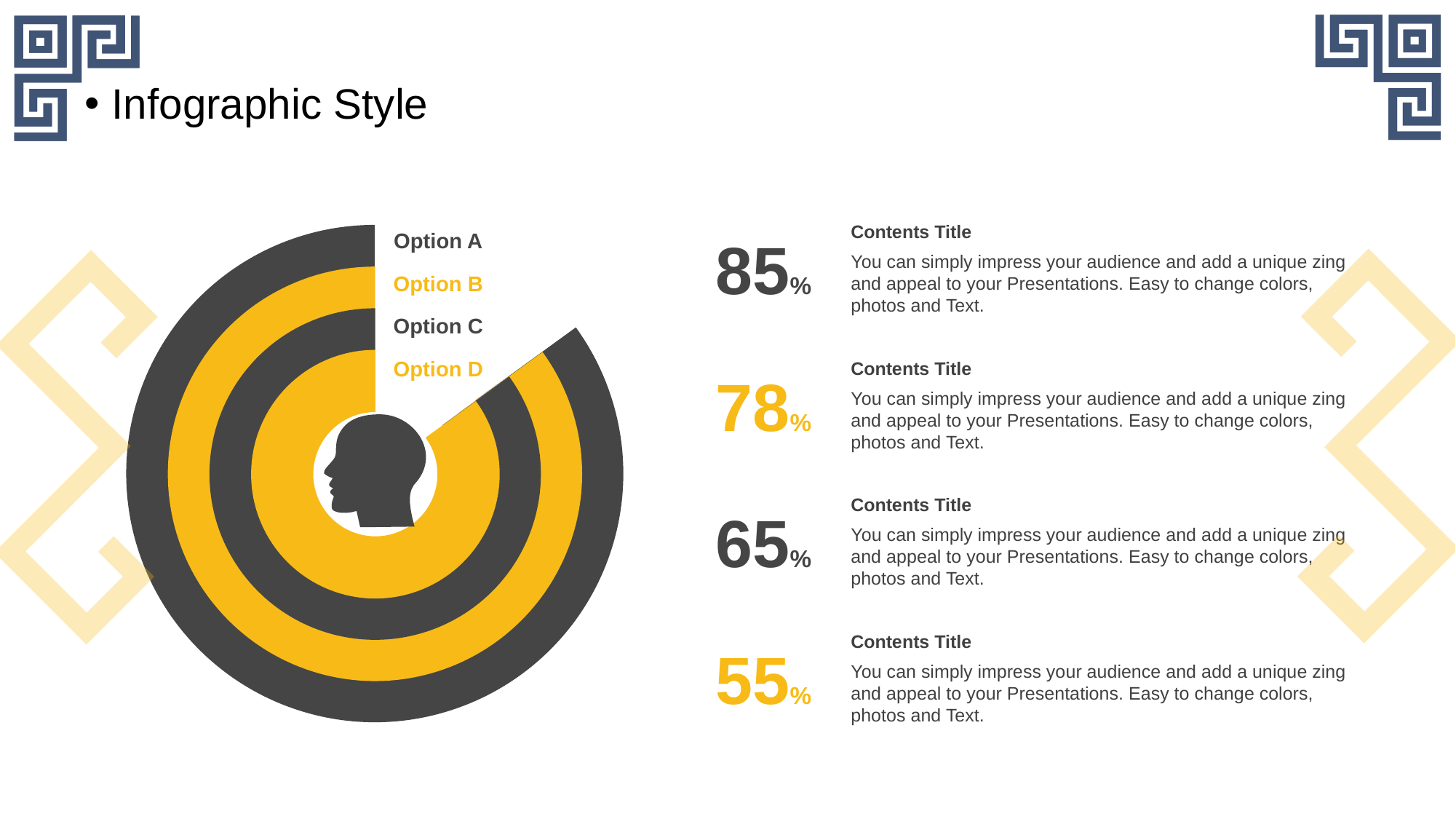
Which option is represented by the outermost ring? Option A What percentage is shown for Option A? 85% How many options are listed in the chart's legend? 4 What is the difference between the percentages for Option A and Option D? 30 percentage points What percentage is shown for Option C? 65% Which option has the highest percentage? Option A What kind of chart is shown on the slide? doughnut chart What percentage is shown for Option D? 55% Which option has the lowest percentage? Option D What percentage is shown for Option B? 78% Which has the larger percentage, Option B or Option C? Option B What colour is the ring for Option B? yellow